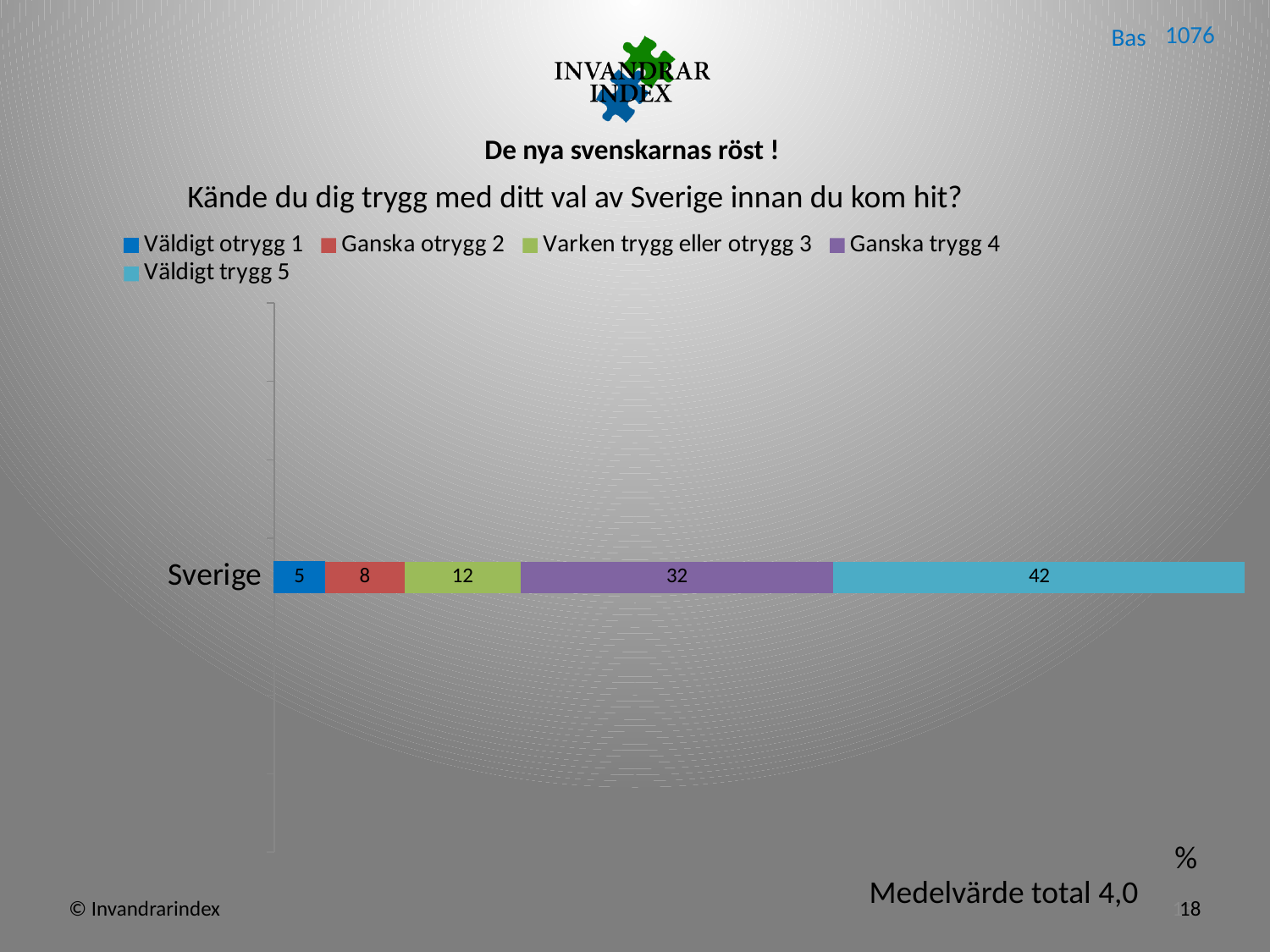
What is the value for Väldigt trygg 5 for Sverige? 42 What kind of chart is shown on the slide? Stacked bar chart What is the difference between the Väldigt trygg 5 and Ganska trygg 4 values for Sverige? 10 Which series has the highest value for Sverige? Väldigt trygg 5 What is the Medelvärde total shown on the slide? 4,0 How many series does the legend list? 5 Which is larger for Sverige: Ganska otrygg 2 or Varken trygg eller otrygg 3? Varken trygg eller otrygg 3 What is the total of the stacked bar for Sverige? 99 Which series has the lowest value for Sverige? Väldigt otrygg 1 What is the value for Ganska trygg 4 for Sverige? 32 What is the value for Väldigt otrygg 1 for Sverige? 5 What is the value for Varken trygg eller otrygg 3 for Sverige? 12